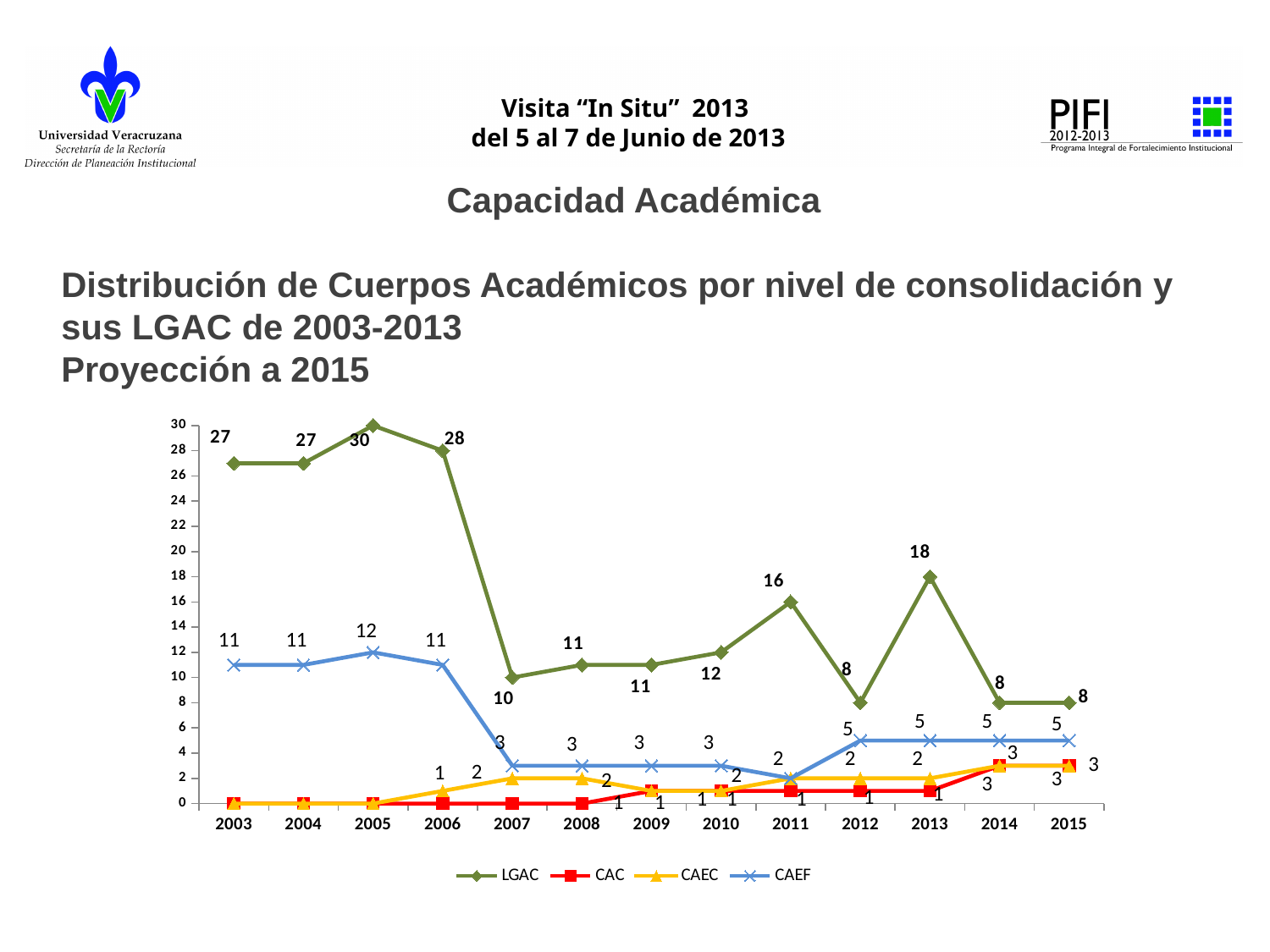
How many series does the legend list? 4 How many years are plotted along the x axis? 13 What is the LGAC value for 2013? 18 What is the lowest value shown for the LGAC series? 8 In which year does the LGAC series reach its highest value? 2005 What is the CAEF value for 2005? 12 What is the LGAC value for 2005? 30 Is the CAEF value for 2003 greater or less than 10? greater What kind of chart is shown on the slide? line chart Which year has the higher LGAC value, 2011 or 2013? 2013 By how much does the LGAC value drop from 2006 to 2007? 18 Does the CAEF series rise or fall between 2006 and 2007? fall